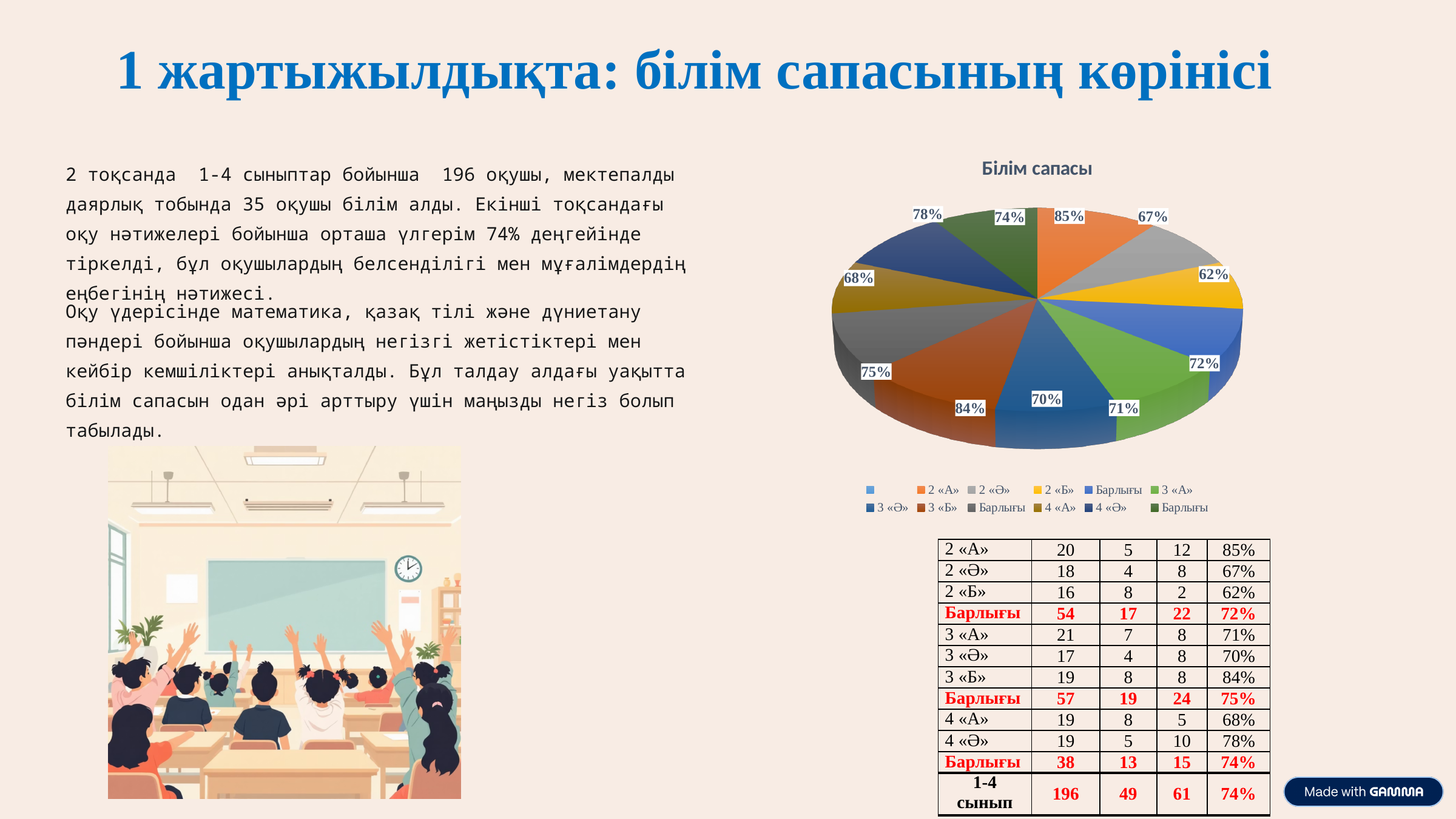
What is the title of the chart? Білім сапасы What is the difference between the values for 2 «А» and 2 «Б»? 23% Which class has the highest value in the chart? 2 «А» What value is shown for 2 «А» in the chart? 85% What value is shown for 4 «Ә» in the chart? 78% Which is larger, the value for 3 «Б» or the value for 4 «Ә»? 3 «Б» What value is shown for 2 «Б» in the chart? 62% What value is shown for 3 «А» in the chart? 71% What value is shown for 2 «Ә» in the chart? 67% What kind of chart is shown on the slide? pie chart Which class has the lowest value in the chart? 2 «Б» What value is shown for 3 «Б» in the chart? 84%